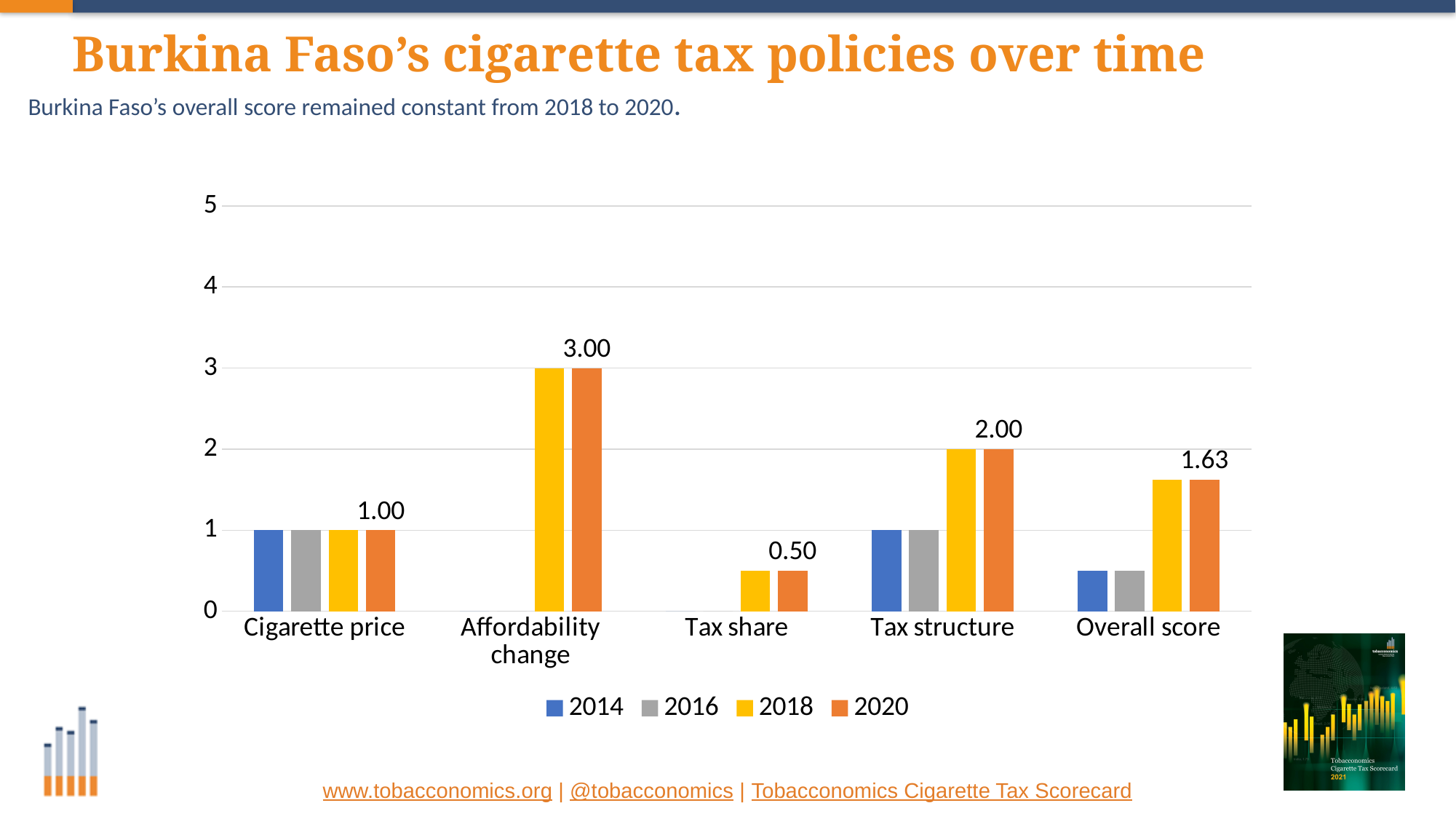
How many categories are shown on the x axis? 5 What is the 2020 value for Tax structure? 2.00 Which category has the lowest 2020 value? Tax share How many series does the legend list? 4 Which category has the highest 2020 value? Affordability change Is the 2014 value for Overall score greater or less than 1? less What kind of chart is shown on the slide? bar chart Which is larger in 2020: Tax structure or Overall score? Tax structure What is the 2020 value for Tax share? 0.50 What is the 2020 value for Affordability change? 3.00 What is the 2020 value for Overall score? 1.63 What is the difference between the 2020 values for Affordability change and Tax structure? 1.00